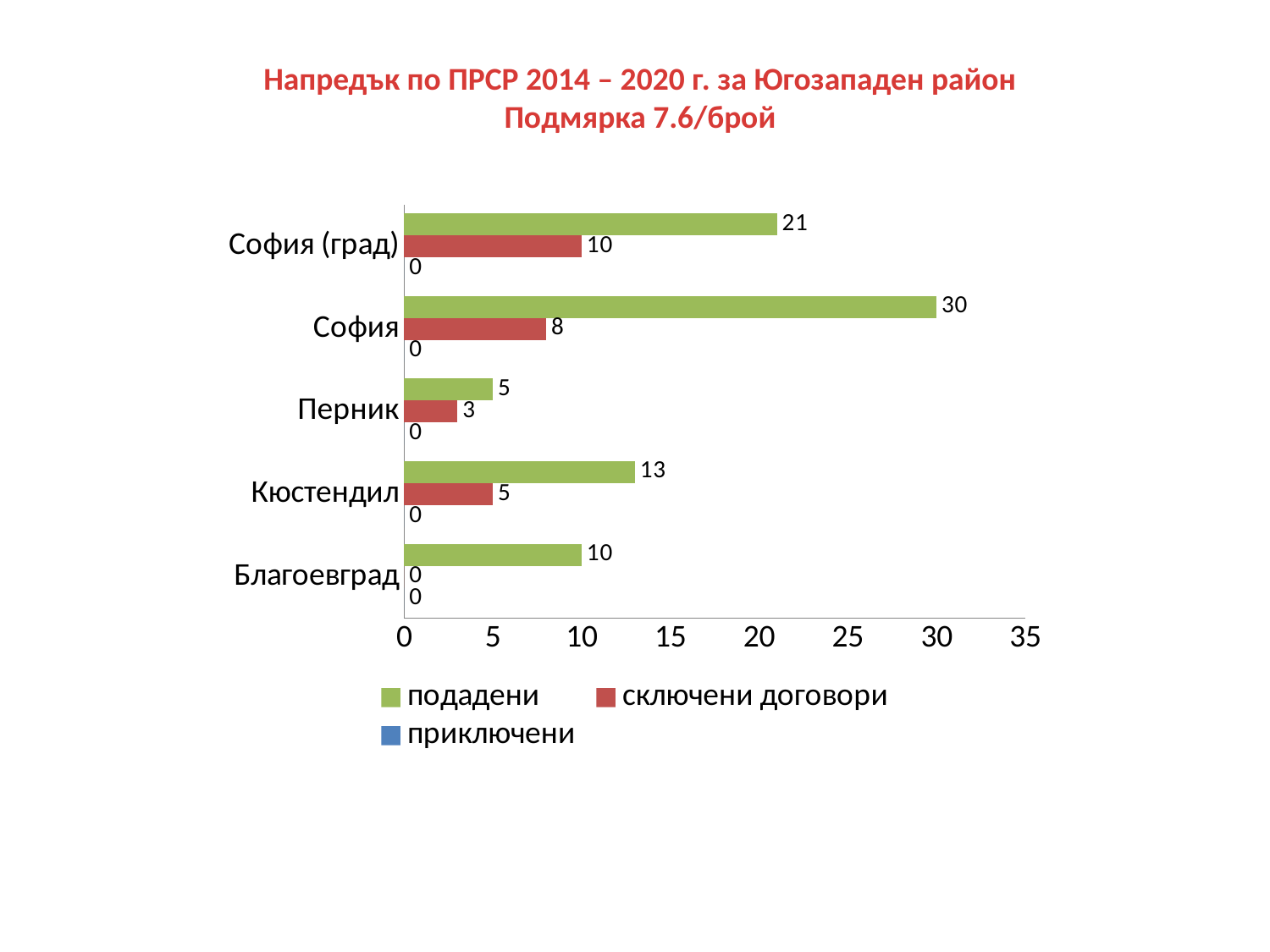
Which series is shown in green in the legend? подадени Which is larger: подадени for София (град) or подадени for Кюстендил? София (град) What is the value of приключени for Перник? 0 How many series does the legend list? 3 What is the value of сключени договори for София (град)? 10 What is the difference between подадени and сключени договори for Кюстендил? 8 What is the value of сключени договори for Благоевград? 0 How many categories are shown on the chart? 5 What kind of chart is shown on the slide? bar chart What is the value of подадени for София? 30 Which category has the lowest value for подадени? Перник Which category has the highest value for подадени? София